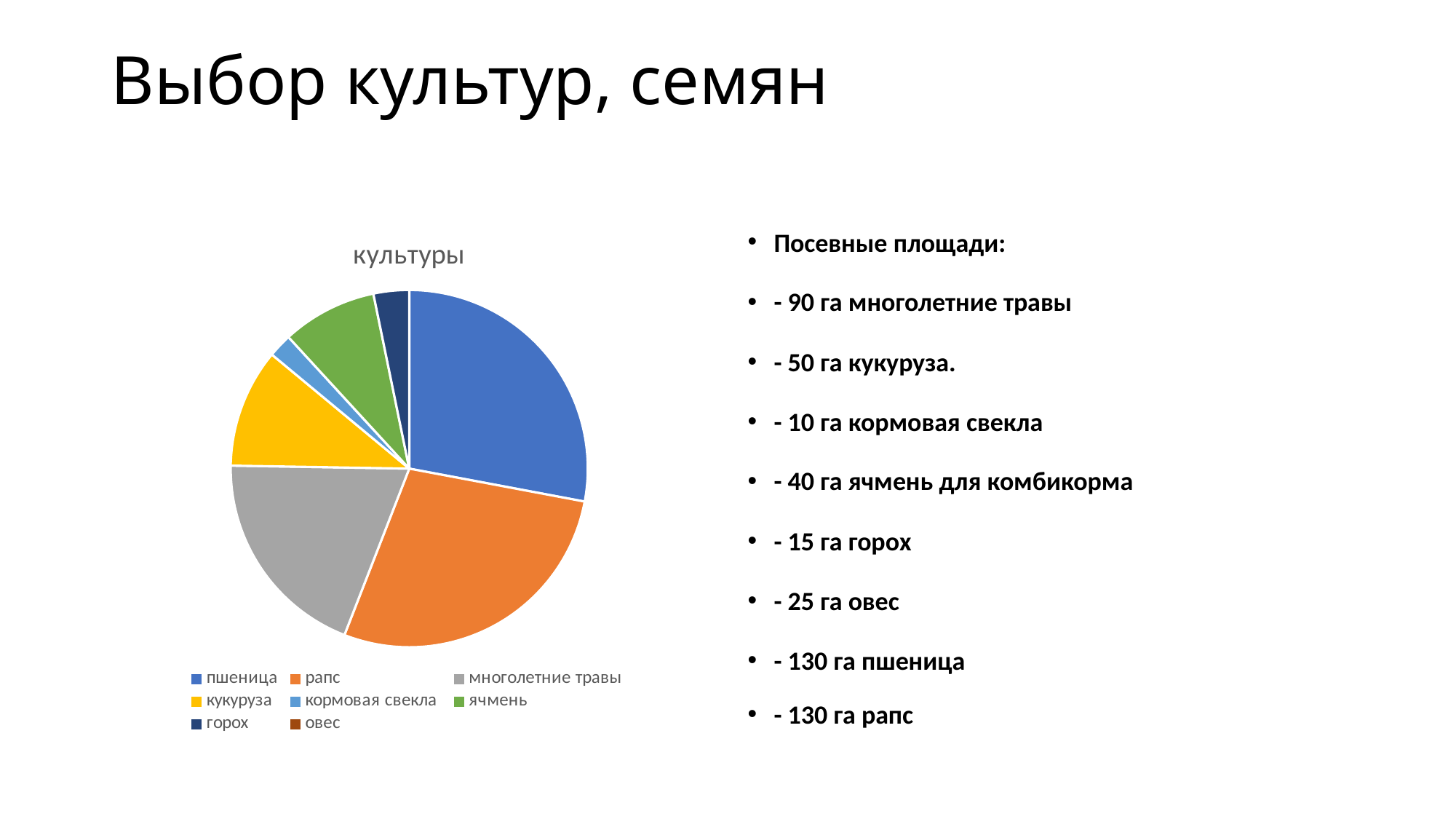
How many categories does the chart legend list? 8 Which is larger in the pie chart, the slice for ячмень or the slice for горох? ячмень Which is larger in the pie chart, the slice for пшеница or the slice for многолетние травы? пшеница What is the title of the chart? культуры Which is larger in the pie chart, the slice for рапс or the slice for кукуруза? рапс What kind of chart is shown on the slide? pie chart What colour is the slice for пшеница in the pie chart? blue